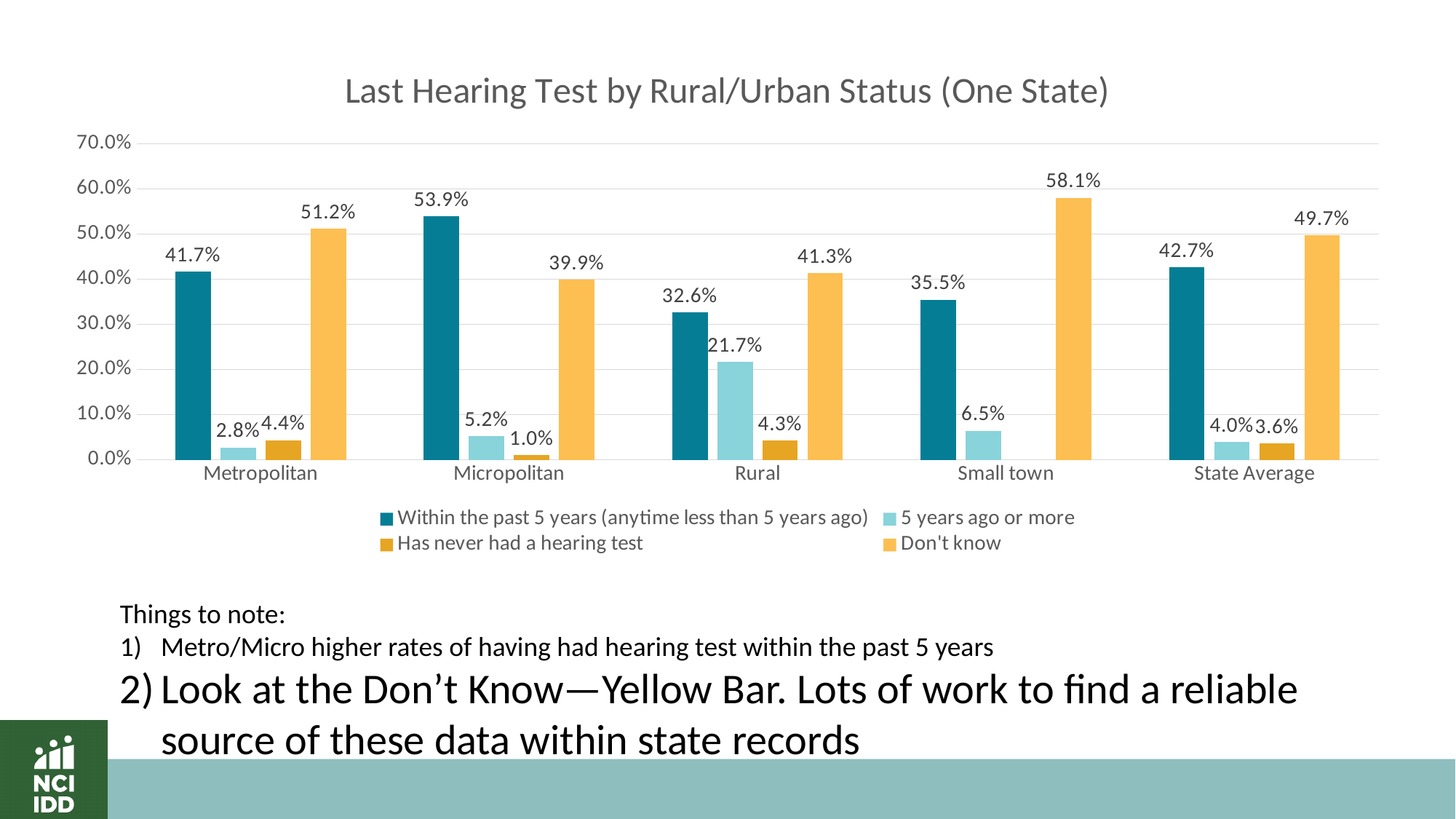
What is the difference between the "Don't know" values for Small town and Micropolitan? 18.2 percentage points Which is larger: the "5 years ago or more" value for Rural or for Metropolitan? Rural How many series does the legend list? 4 What is the value of "5 years ago or more" for Rural? 21.7% What is the value of "Within the past 5 years (anytime less than 5 years ago)" for Micropolitan? 53.9% How many categories are shown on the x axis? 5 Which category has the highest value for "Within the past 5 years (anytime less than 5 years ago)"? Micropolitan Which category has the highest "Don't know" value? Small town What kind of chart is shown on the slide? Bar chart Which category has the lowest value for "Within the past 5 years (anytime less than 5 years ago)"? Rural What is the title of the chart? Last Hearing Test by Rural/Urban Status (One State) What is the value of the "Don't know" series for Small town? 58.1%